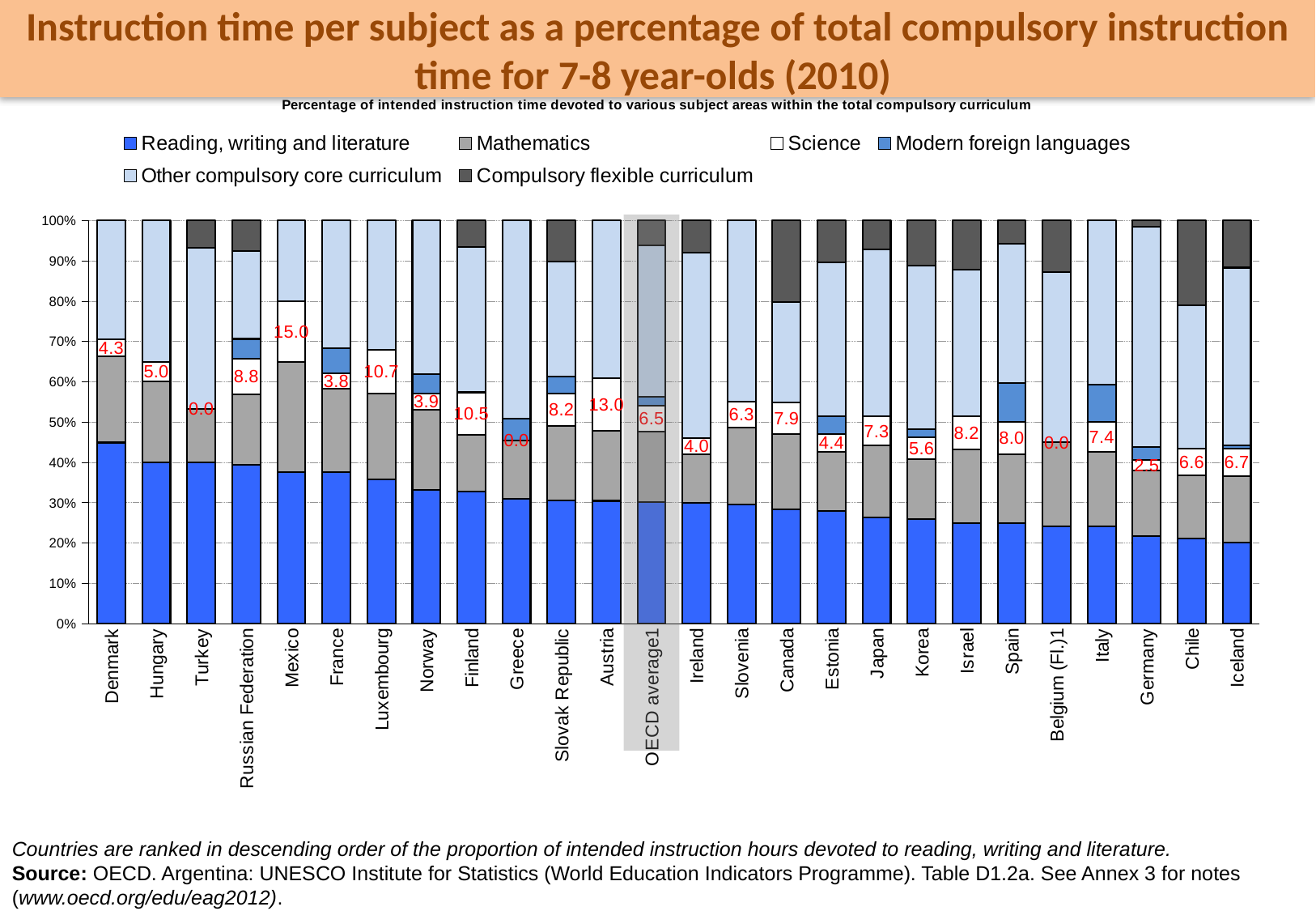
What data label is printed on the bar for Austria? 13.0 What data label is printed on the bar for OECD average1? 6.5 What kind of chart is shown on the slide? Stacked bar chart What data label is printed on the bar for Mexico? 15.0 Which category on the x axis is highlighted with a grey shaded background? OECD average1 How many countries/categories are shown along the x axis? 26 Does the Reading, writing and literature segment rise or fall from left to right across the countries? fall What is the difference between the printed data labels for Mexico and Austria? 2.0 Which country has the highest printed data label on its bar? Mexico Which has the larger printed data label, Austria or Slovak Republic? Austria Is the Reading, writing and literature segment for Denmark greater or less than 40%? greater How many series does the legend list? 6